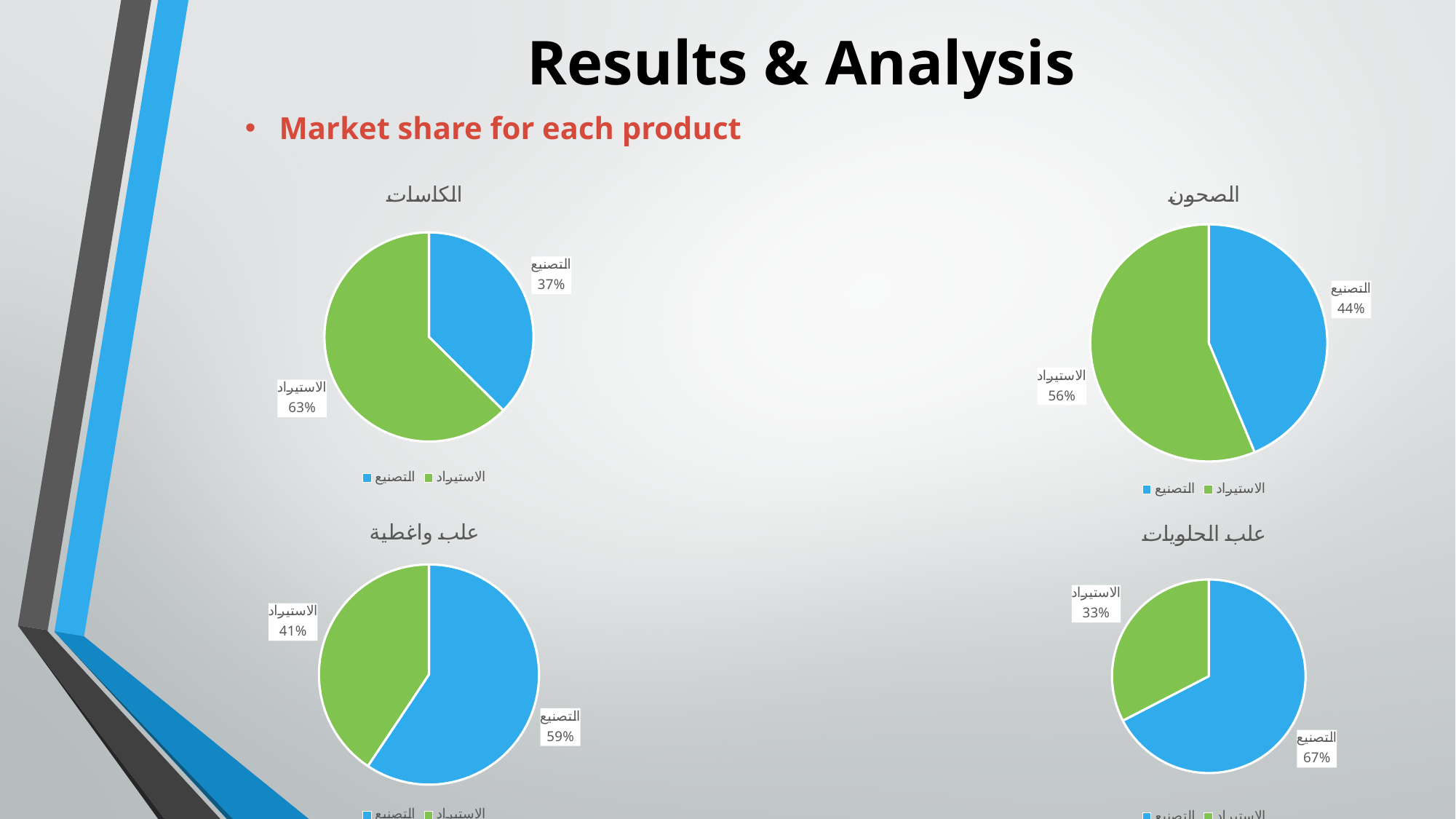
In the top-right pie chart titled "الصحون", what is the share for "الاستيراد"? 56% In the bottom-right pie chart titled "علب الحلويات", what is the share for "الاستيراد"? 33% In the bottom-left pie chart titled "علب واغطية", what is the difference between the "التصنيع" and "الاستيراد" shares? 18% In the top-left pie chart titled "الكاسات", what is the share for "التصنيع"? 37% What type of chart is the top-left chart titled "الكاسات"? Pie chart In the top-left pie chart titled "الكاسات", which slice is the smallest? التصنيع In the top-right pie chart titled "الصحون", what is the share for "التصنيع"? 44% In the top-right pie chart titled "الصحون", which is larger, "التصنيع" or "الاستيراد"? الاستيراد In the bottom-right pie chart titled "علب الحلويات", which slice is the largest? التصنيع In the bottom-left pie chart titled "علب واغطية", what is the share for "التصنيع"? 59% In the top-left pie chart titled "الكاسات", what is the share for "الاستيراد"? 63% How many slices does the bottom-right pie chart titled "علب الحلويات" have? 2